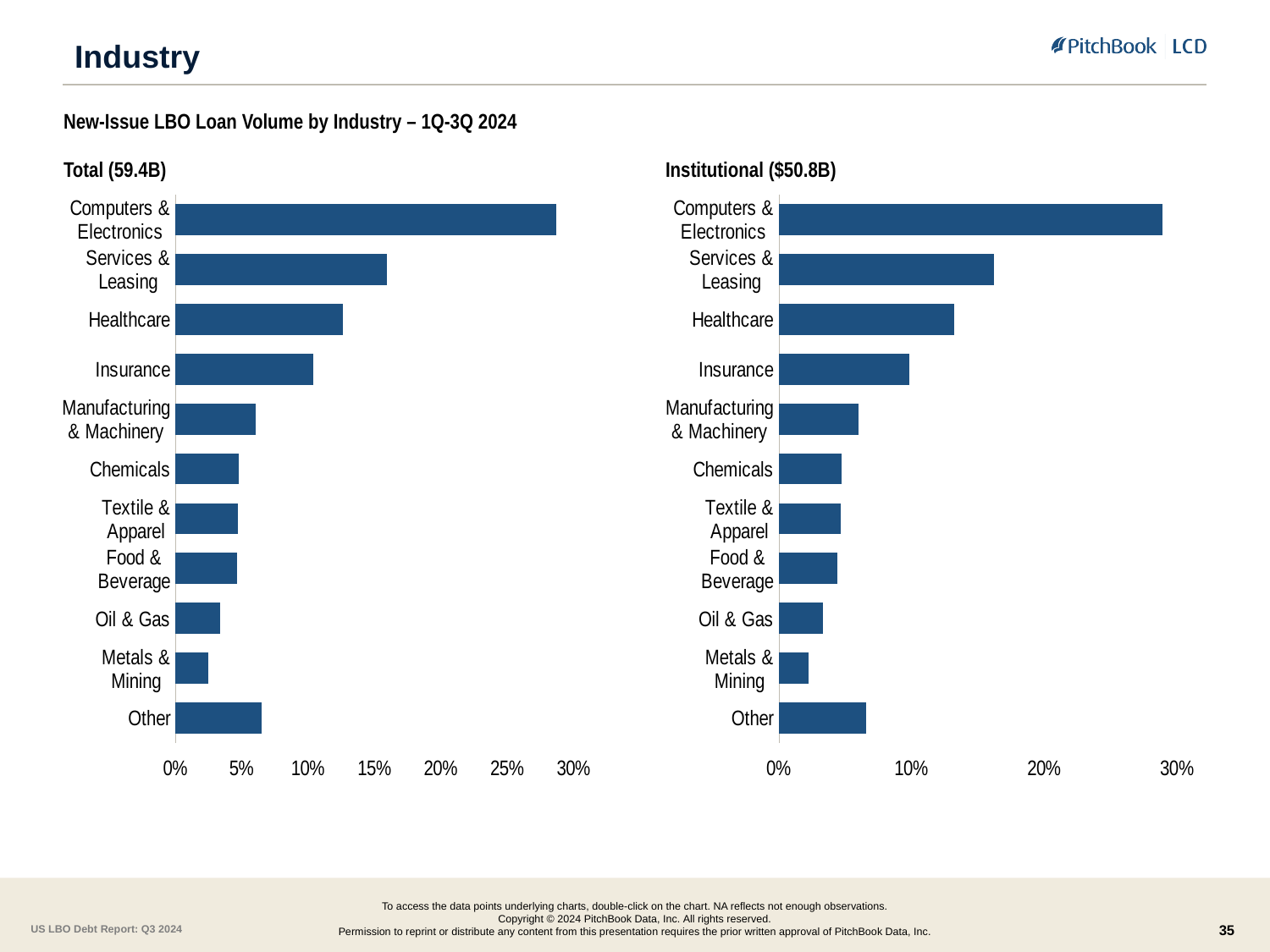
In the 'Institutional ($50.8B)' chart, is the value for Oil & Gas greater or less than 10%? less In the 'Total (59.4B)' chart, which industry has the highest share? Computers & Electronics In the 'Institutional ($50.8B)' chart, which is larger, Other or Chemicals? Other In the 'Institutional ($50.8B)' chart, is the value for Computers & Electronics greater or less than 20%? greater How many industry categories are shown in the 'Total (59.4B)' chart? 11 What is the title of the chart on the right? Institutional ($50.8B) In the 'Total (59.4B)' chart, is the value for Computers & Electronics greater or less than 25%? greater In the 'Institutional ($50.8B)' chart, which industry has the highest share? Computers & Electronics In the 'Institutional ($50.8B)' chart, which industry has the lowest share? Metals & Mining What kind of chart is the 'Total (59.4B)' chart on the left? bar chart In the 'Total (59.4B)' chart, which is larger, Healthcare or Insurance? Healthcare